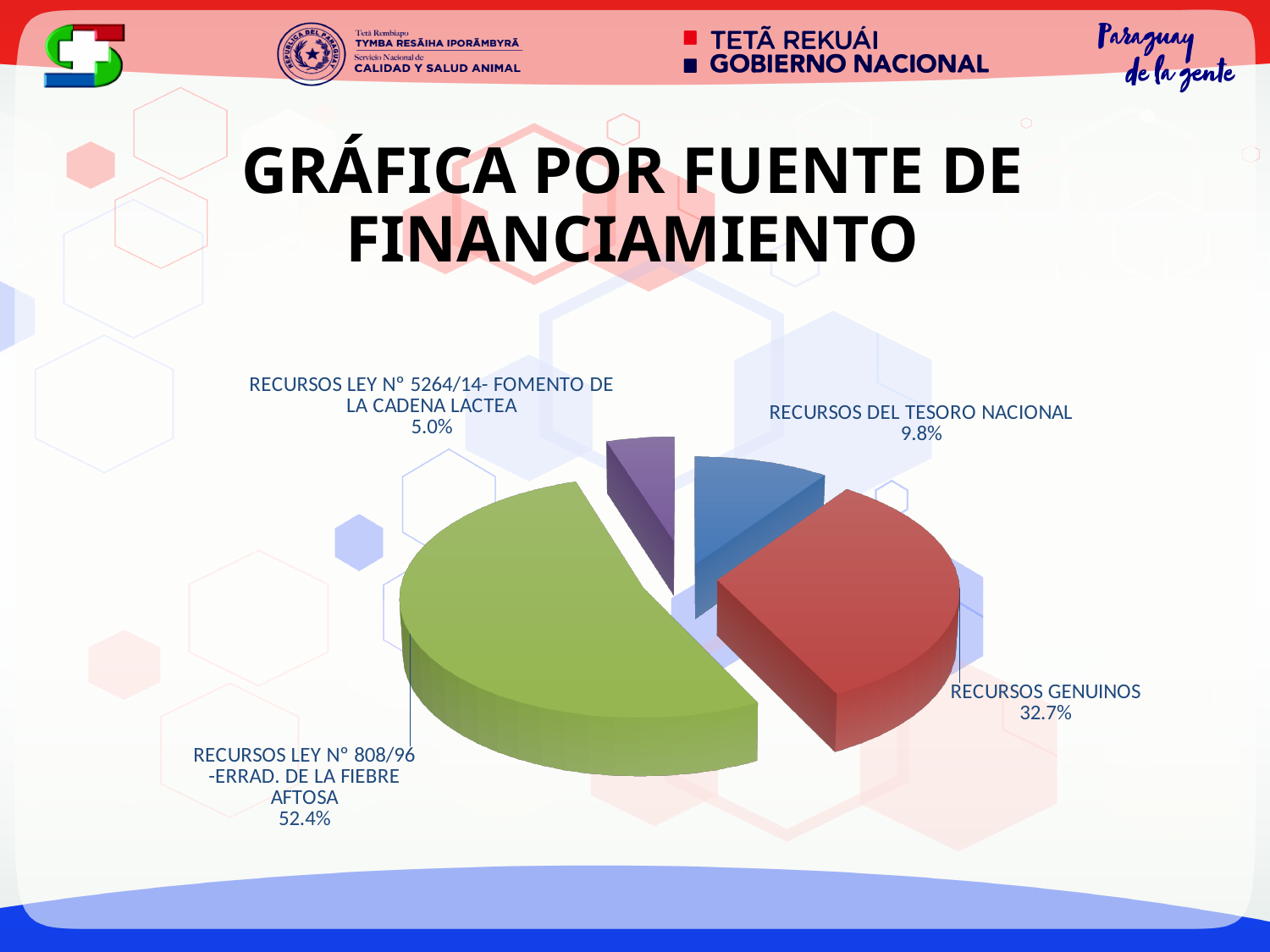
How many slices does the pie chart have? 4 What type of chart is shown on the slide? Pie chart Which is larger: RECURSOS DEL TESORO NACIONAL or RECURSOS LEY N° 5264/14- FOMENTO DE LA CADENA LACTEA? RECURSOS DEL TESORO NACIONAL What colour is the slice for RECURSOS GENUINOS? Red What share of the pie does RECURSOS GENUINOS represent? 32.7% What share of the pie does RECURSOS LEY N° 5264/14- FOMENTO DE LA CADENA LACTEA represent? 5.0% Which funding source has the largest slice of the pie? RECURSOS LEY N° 808/96 -ERRAD. DE LA FIEBRE AFTOSA What is the difference in percentage points between RECURSOS GENUINOS and RECURSOS DEL TESORO NACIONAL? 22.9 What is the title of the slide containing the chart? GRÁFICA POR FUENTE DE FINANCIAMIENTO What share of the pie does RECURSOS DEL TESORO NACIONAL represent? 9.8% What share of the pie does RECURSOS LEY N° 808/96 -ERRAD. DE LA FIEBRE AFTOSA represent? 52.4% Which funding source has the smallest slice of the pie? RECURSOS LEY N° 5264/14- FOMENTO DE LA CADENA LACTEA